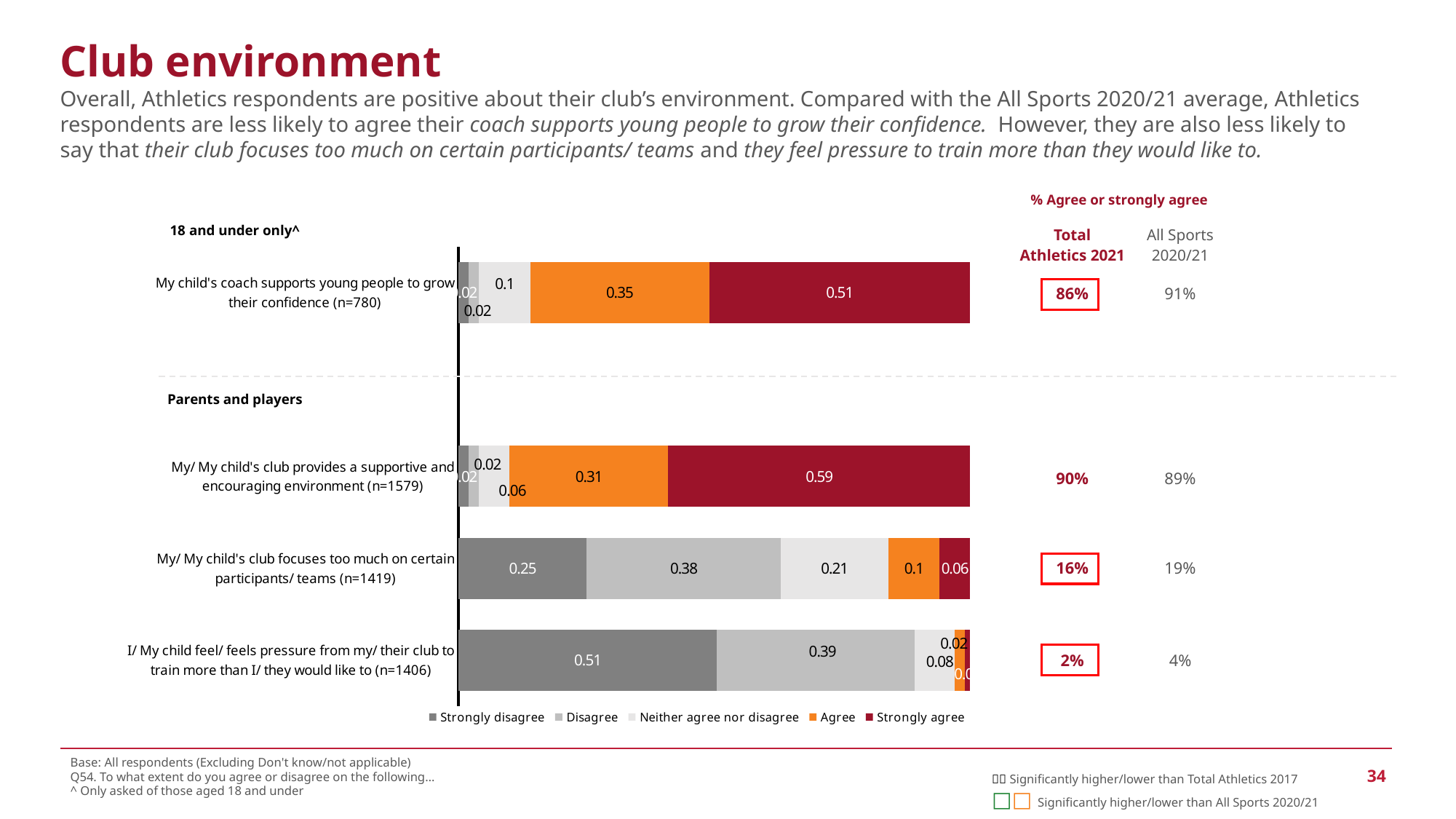
How many statements (bars) are plotted in the chart? 4 What is the 'Strongly disagree' value for 'I/ My child feel/ feels pressure from my/ their club to train more than I/ they would like to (n=1406)'? 0.51 Which is larger for 'My/ My child's club focuses too much on certain participants/ teams': the 'Strongly disagree' value or the 'Neither agree nor disagree' value? Strongly disagree How many series does the legend list? 5 What is the 'Agree' value for 'My child's coach supports young people to grow their confidence (n=780)'? 0.35 Which statement has the highest 'Strongly agree' value? My/ My child's club provides a supportive and encouraging environment (n=1579) What is the 'Strongly agree' value for 'My/ My child's club provides a supportive and encouraging environment (n=1579)'? 0.59 What is the Total Athletics 2021 '% Agree or strongly agree' figure for 'My/ My child's club focuses too much on certain participants/ teams'? 16% What kind of chart is shown on the slide? Stacked bar chart What is the difference between the 'Strongly agree' values for 'My/ My child's club provides a supportive and encouraging environment' and 'My child's coach supports young people to grow their confidence'? 0.08 What is the 'Disagree' value for 'My/ My child's club focuses too much on certain participants/ teams (n=1419)'? 0.38